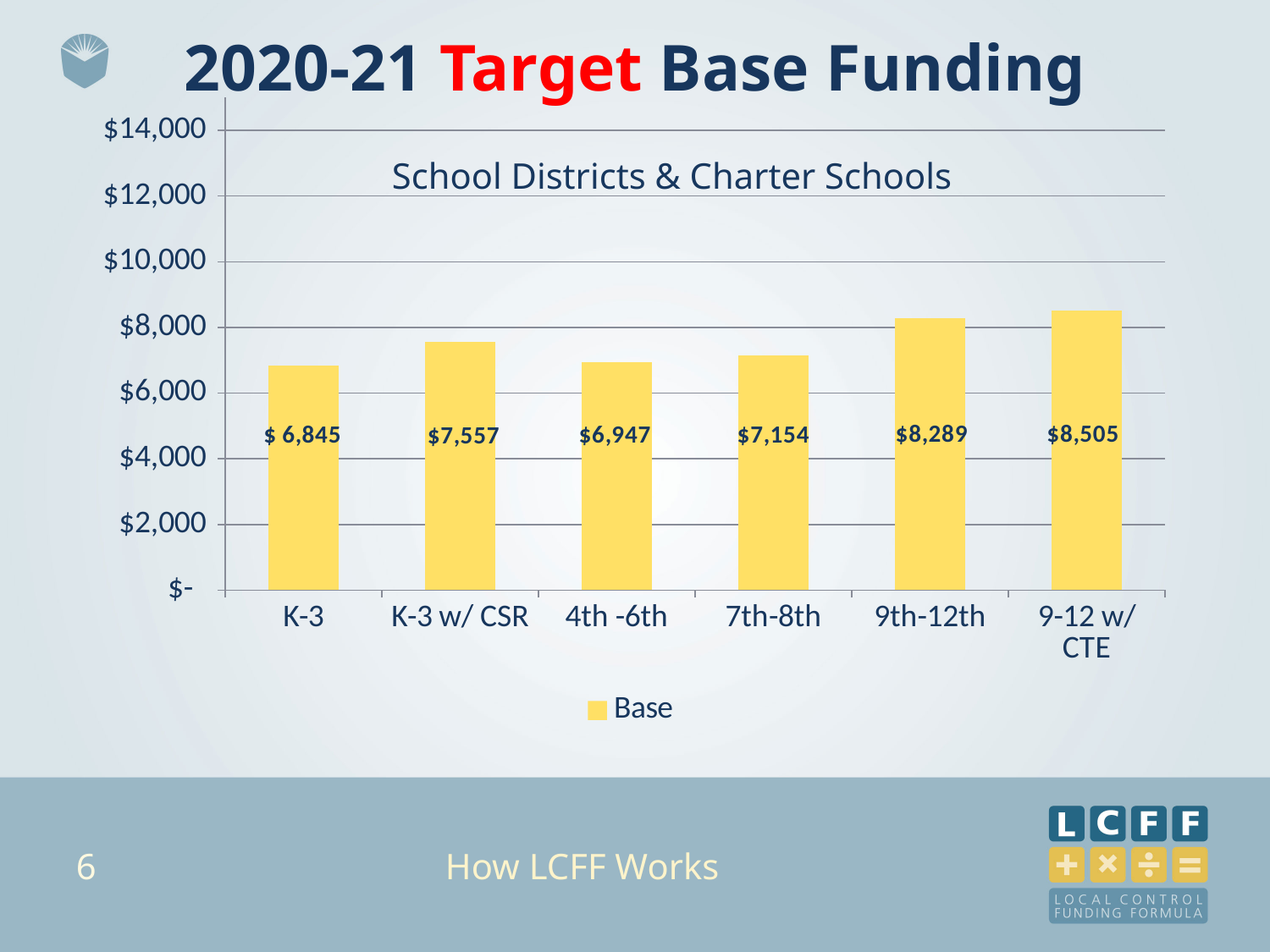
Which category has the lowest Base value? K-3 How many categories are shown on the x axis? 6 What is the Base value for K-3 w/ CSR? $7,557 What is the difference between the Base values for 9-12 w/ CTE and 9th-12th? $216 Which category has the highest Base value? 9-12 w/ CTE How many series does the legend list? 1 Is the Base value for 9th-12th greater or less than $8,000? greater What is the difference between the Base values for K-3 w/ CSR and K-3? $712 Which is larger, the Base value for 7th-8th or for 4th -6th? 7th-8th What is the Base value for 4th -6th? $6,947 What is the Base value for 9th-12th? $8,289 What kind of chart is shown on the slide? bar chart